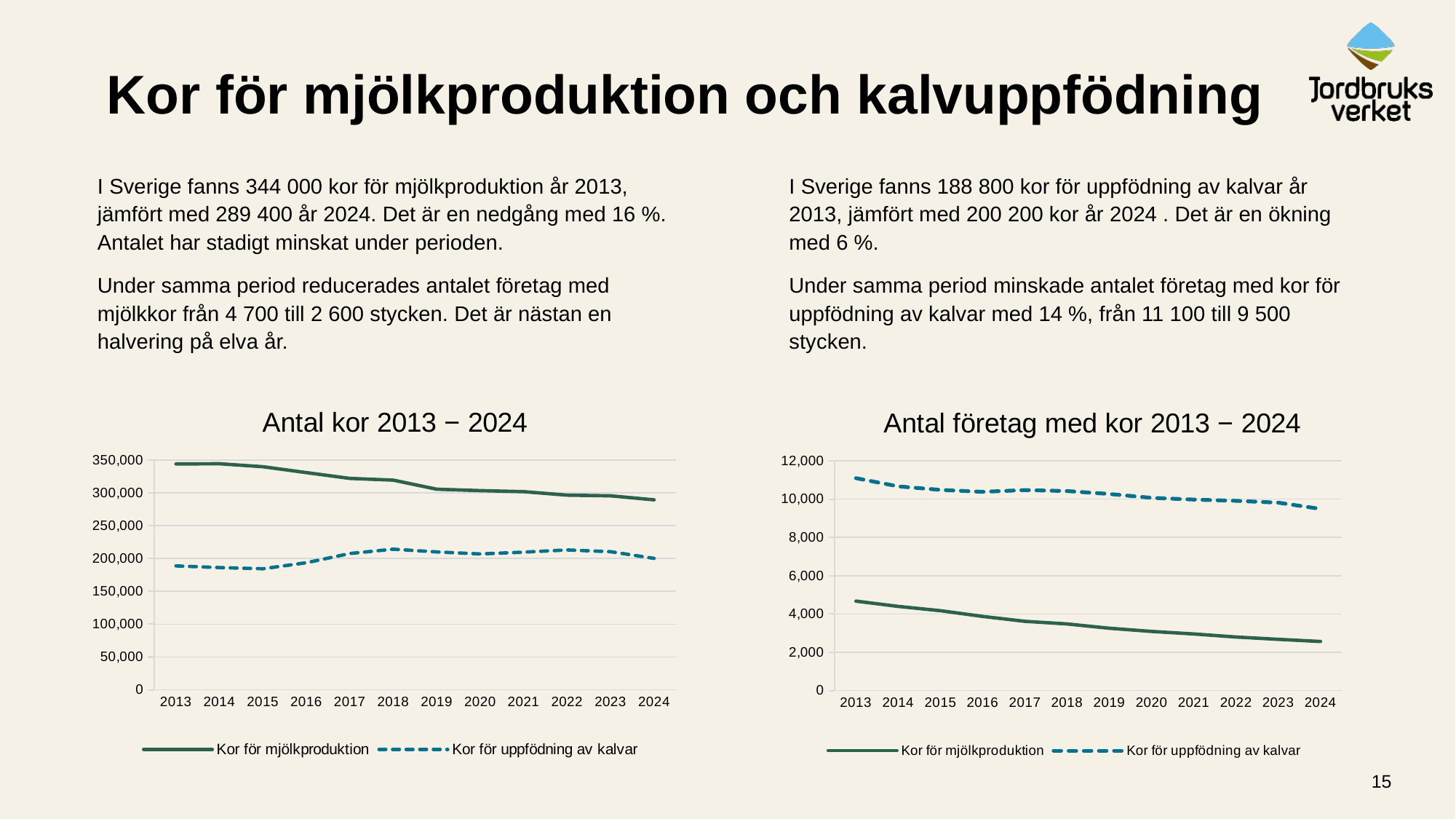
In the 'Antal kor 2013 − 2024' chart, which series has the higher value in 2013, 'Kor för mjölkproduktion' or 'Kor för uppfödning av kalvar'? Kor för mjölkproduktion In the 'Antal företag med kor 2013 − 2024' chart, is the value for 'Kor för mjölkproduktion' in 2024 greater or less than 4,000? less In the 'Antal företag med kor 2013 − 2024' chart, is the value for 'Kor för uppfödning av kalvar' in 2013 greater or less than 10,000? greater In the 'Antal företag med kor 2013 − 2024' chart, does the 'Kor för mjölkproduktion' line rise or fall from 2013 to 2024? Fall In the 'Antal kor 2013 − 2024' chart, is the value for 'Kor för mjölkproduktion' in 2013 greater or less than 300,000? greater In the 'Antal kor 2013 − 2024' chart, which series is drawn with a dashed line? Kor för uppfödning av kalvar How many series does the legend of the 'Antal företag med kor 2013 − 2024' chart list? 2 In the 'Antal företag med kor 2013 − 2024' chart, which series has the higher value in 2024, 'Kor för mjölkproduktion' or 'Kor för uppfödning av kalvar'? Kor för uppfödning av kalvar What kind of chart is the 'Antal kor 2013 − 2024' chart? Line chart How many years are plotted along the x axis of the 'Antal kor 2013 − 2024' chart? 12